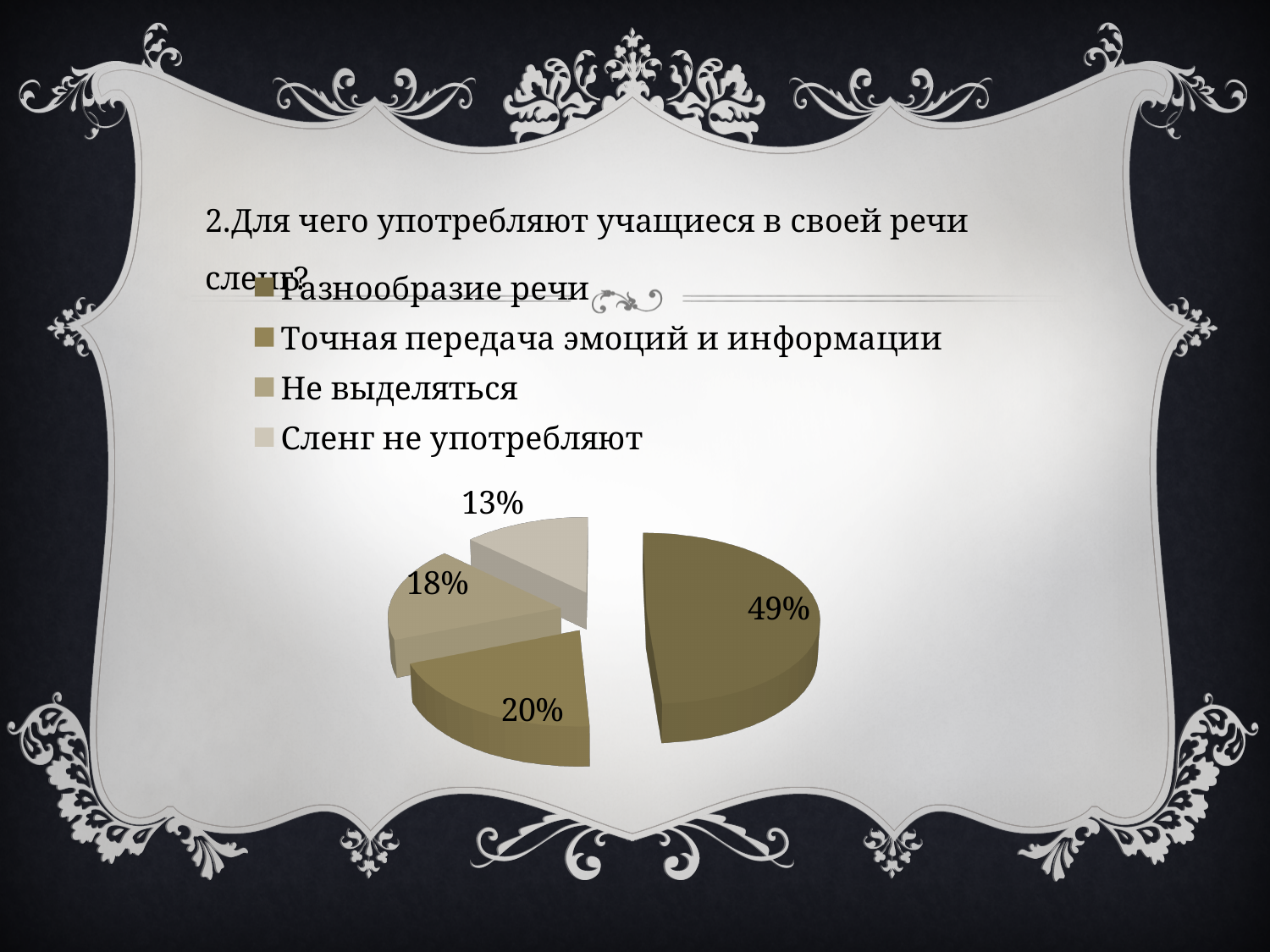
Which category has the smallest share of the pie? Сленг не употребляют Which legend entry is shown in the lightest colour? Сленг не употребляют How many slices does the pie chart have? 4 What percentage is shown for "Сленг не употребляют"? 13% What percentage is shown for "Точная передача эмоций и информации"? 20% What kind of chart is shown on the slide? pie chart How many entries does the legend list? 4 What percentage is shown for "Разнообразие речи"? 49% Which category has the largest share of the pie? Разнообразие речи Which is larger: the share for "Не выделяться" or the share for "Сленг не употребляют"? Не выделяться What percentage is shown for "Не выделяться"? 18% What is the difference between the shares for "Разнообразие речи" and "Точная передача эмоций и информации"? 29%